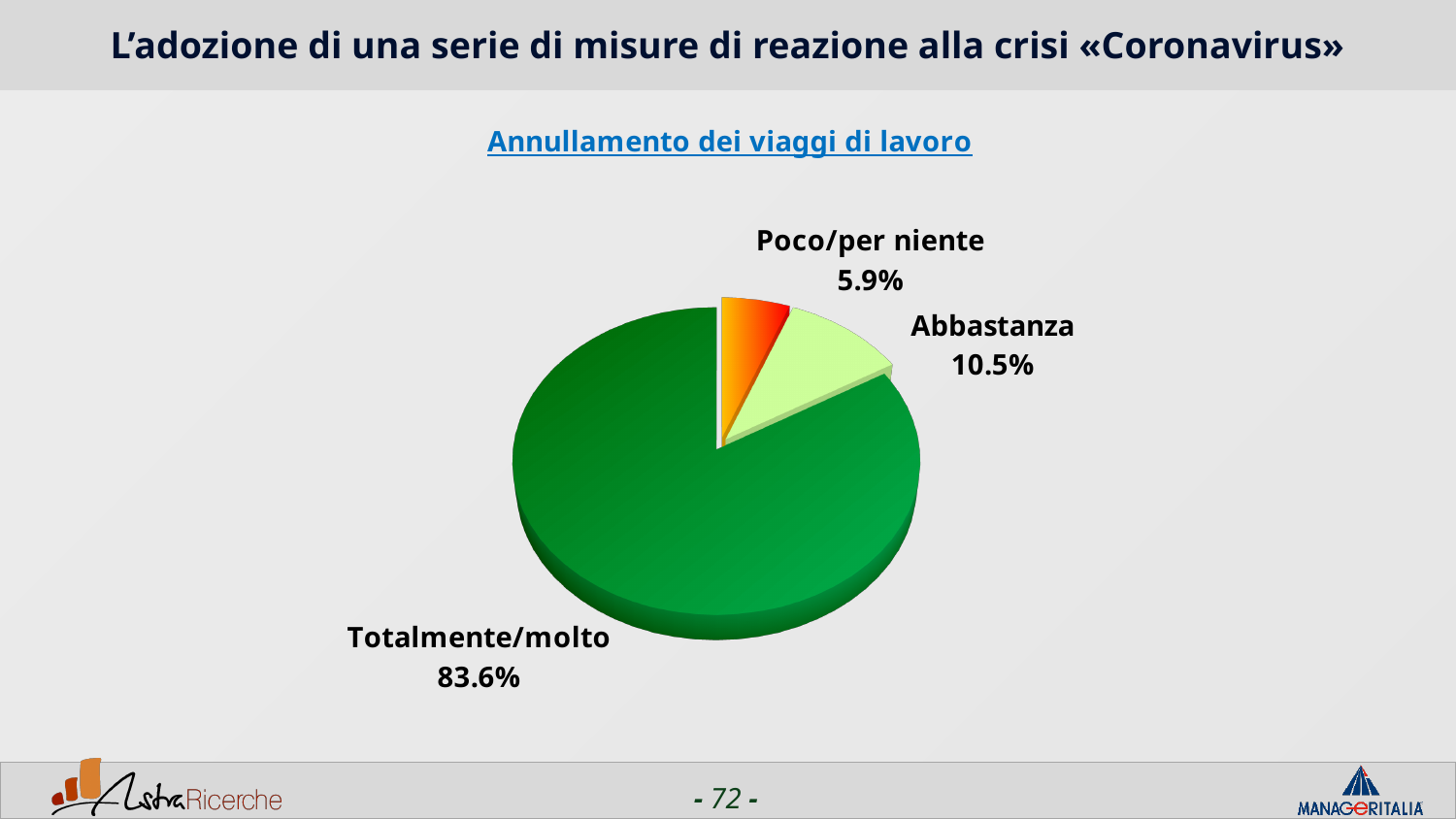
Which is larger, the value for Abbastanza or the value for Poco/per niente? Abbastanza What colour is the Totalmente/molto slice? Green What is the value for Poco/per niente? 5.9% What is the value for Abbastanza? 10.5% What is the difference between the values for Totalmente/molto and Abbastanza? 73.1% How many slices does the pie chart have? 3 What is the difference between the values for Abbastanza and Poco/per niente? 4.6% What is the value for Totalmente/molto? 83.6% Which category has the smallest share of the pie? Poco/per niente What is the title of the chart? Annullamento dei viaggi di lavoro What kind of chart is shown on the slide? Pie chart Which category has the largest share of the pie? Totalmente/molto